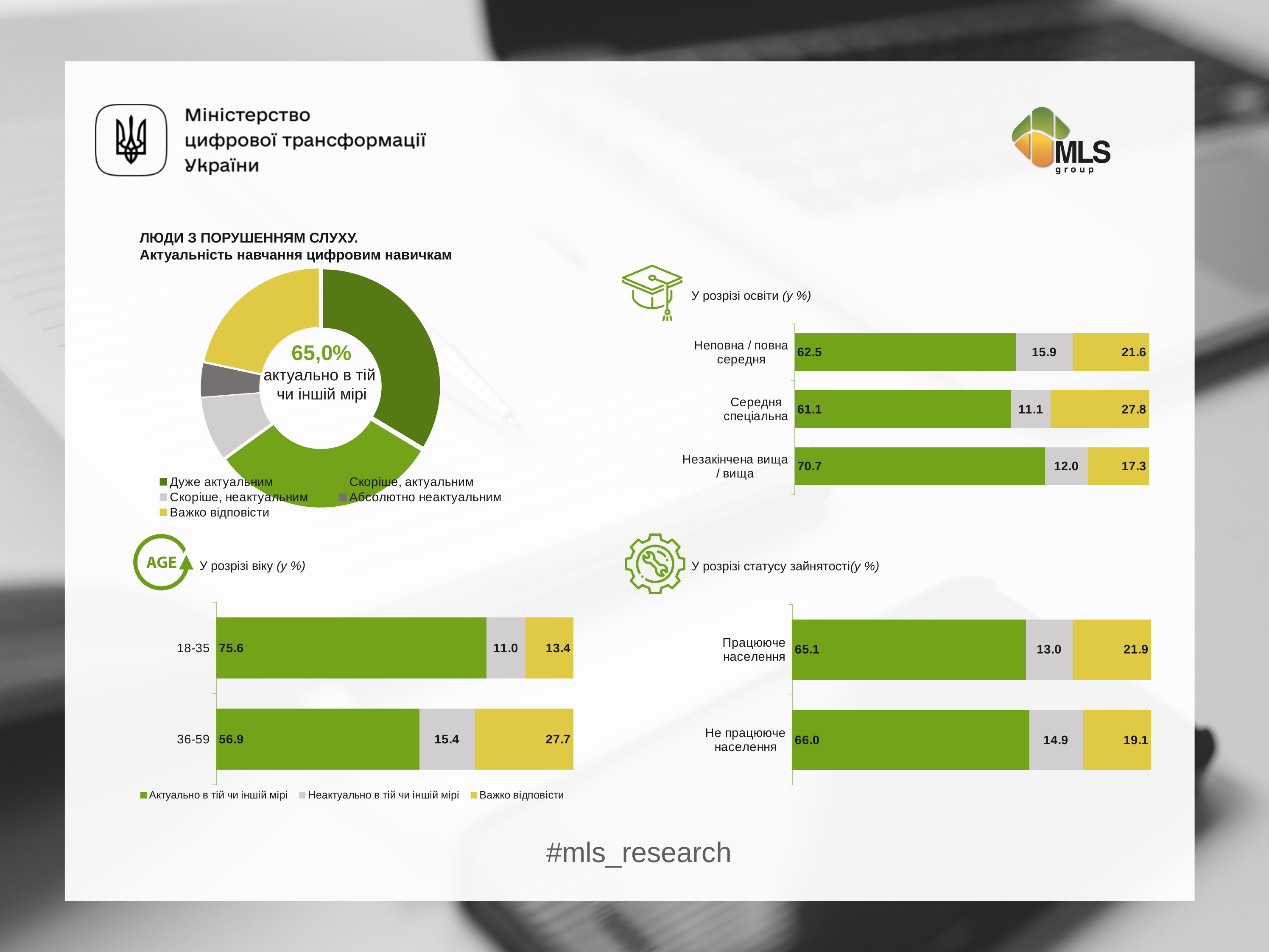
How many series does the legend of the 'У розрізі віку' chart list? 3 What percentage is shown in the centre of the donut chart 'Актуальність навчання цифровим навичкам'? 65,0% In the 'У розрізі віку' chart, what is the difference between the green 'Актуально' values for 18-35 and 36-59? 18.7 In the 'У розрізі статусу зайнятості' chart, which group has the larger 'Важко відповісти' value: 'Працююче населення' or 'Не працююче населення'? Працююче населення In the 'У розрізі статусу зайнятості' chart, what is the grey 'Неактуально' value for 'Не працююче населення'? 14.9 How many education categories are shown in the 'У розрізі освіти' chart? 3 In the 'У розрізі освіти' chart, what is the total of the three segments for 'Середня спеціальна'? 100.0 In the 'У розрізі віку' chart, what is the 'Важко відповісти' value for the 36-59 age group? 27.7 In the 'У розрізі освіти' chart, which education category has the highest green 'Актуально' value? Незакінчена вища / вища What type of chart is the 'У розрізі статусу зайнятості' chart? Bar chart In the 'У розрізі освіти' chart, what is the value of the green 'Актуально' segment for 'Незакінчена вища / вища'? 70.7 In the 'У розрізі віку' chart, which age group has the lowest 'Важко відповісти' value? 18-35